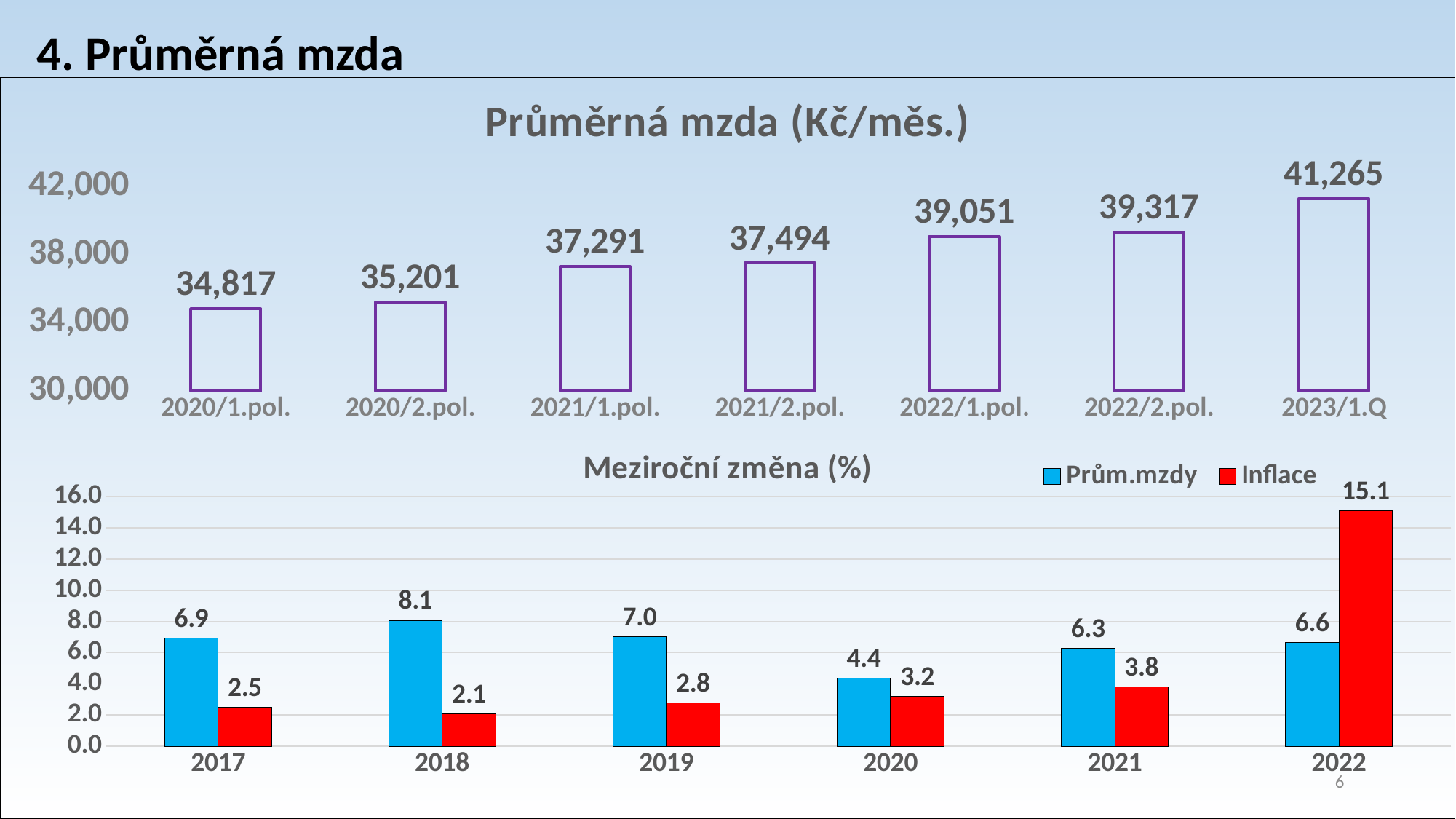
In the 'Meziroční změna (%)' chart, what is the Inflace value for 2022? 15.1 In the 'Průměrná mzda (Kč/měs.)' chart, do the values rise or fall from 2020/1.pol. to 2023/1.Q? rise In the 'Průměrná mzda (Kč/měs.)' chart, which category has the lowest value? 2020/1.pol. In the 'Průměrná mzda (Kč/měs.)' chart, what is the value for 2021/1.pol.? 37,291 How many series does the legend of the 'Meziroční změna (%)' chart list? 2 In the 'Meziroční změna (%)' chart, which year has the highest Prům.mzdy value? 2018 In the 'Průměrná mzda (Kč/měs.)' chart, how many categories are shown on the x axis? 7 In the 'Meziroční změna (%)' chart, what is the Prům.mzdy value for 2020? 4.4 In the 'Průměrná mzda (Kč/měs.)' chart, what is the difference between the values for 2022/2.pol. and 2022/1.pol.? 266 In the 'Meziroční změna (%)' chart, which is larger for 2021: Prům.mzdy or Inflace? Prům.mzdy In the 'Průměrná mzda (Kč/měs.)' chart, which category has the highest value? 2023/1.Q In the 'Meziroční změna (%)' chart, what is the difference between Inflace and Prům.mzdy for 2022? 8.5